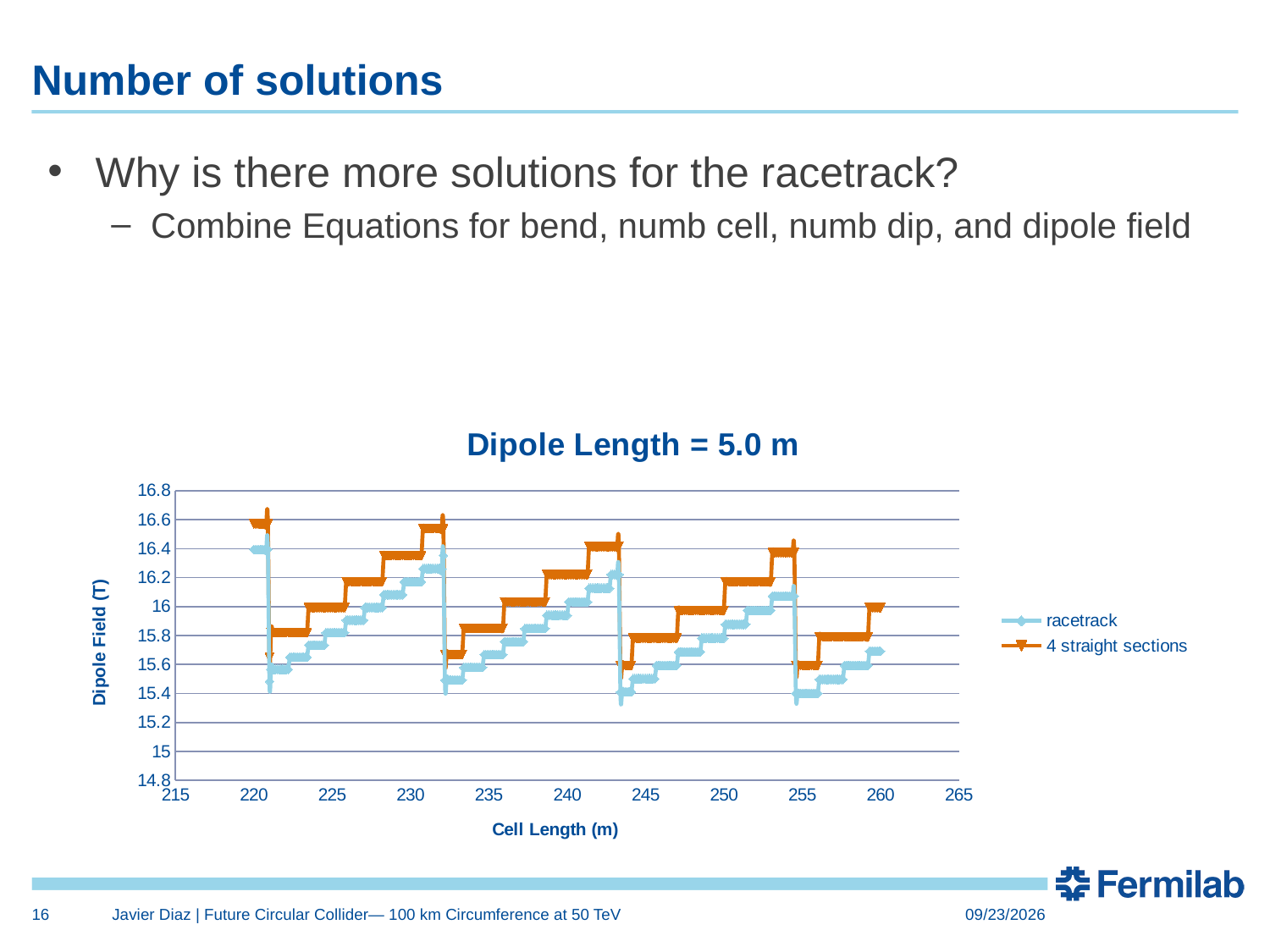
At a cell length of 230 m, which series has the higher dipole field, racetrack or 4 straight sections? 4 straight sections Which series generally lies higher on the chart, racetrack or 4 straight sections? 4 straight sections What are the names of the two series in the legend? racetrack and 4 straight sections Is the value of the 4 straight sections series at a cell length of 220 m greater or less than 16.4? greater Does the dipole field for the racetrack series rise or fall between cell lengths of 233 m and 242 m? rise How many series does the legend list? 2 Between cell lengths of 222 m and 231 m, does the 4 straight sections series rise or fall? rise What kind of chart is shown on the slide? line chart Is the value of the 4 straight sections series at a cell length of 230 m greater or less than 16.2? greater Is the value of the racetrack series at a cell length of 255 m greater or less than 15.6? less What is the title of the chart? Dipole Length = 5.0 m